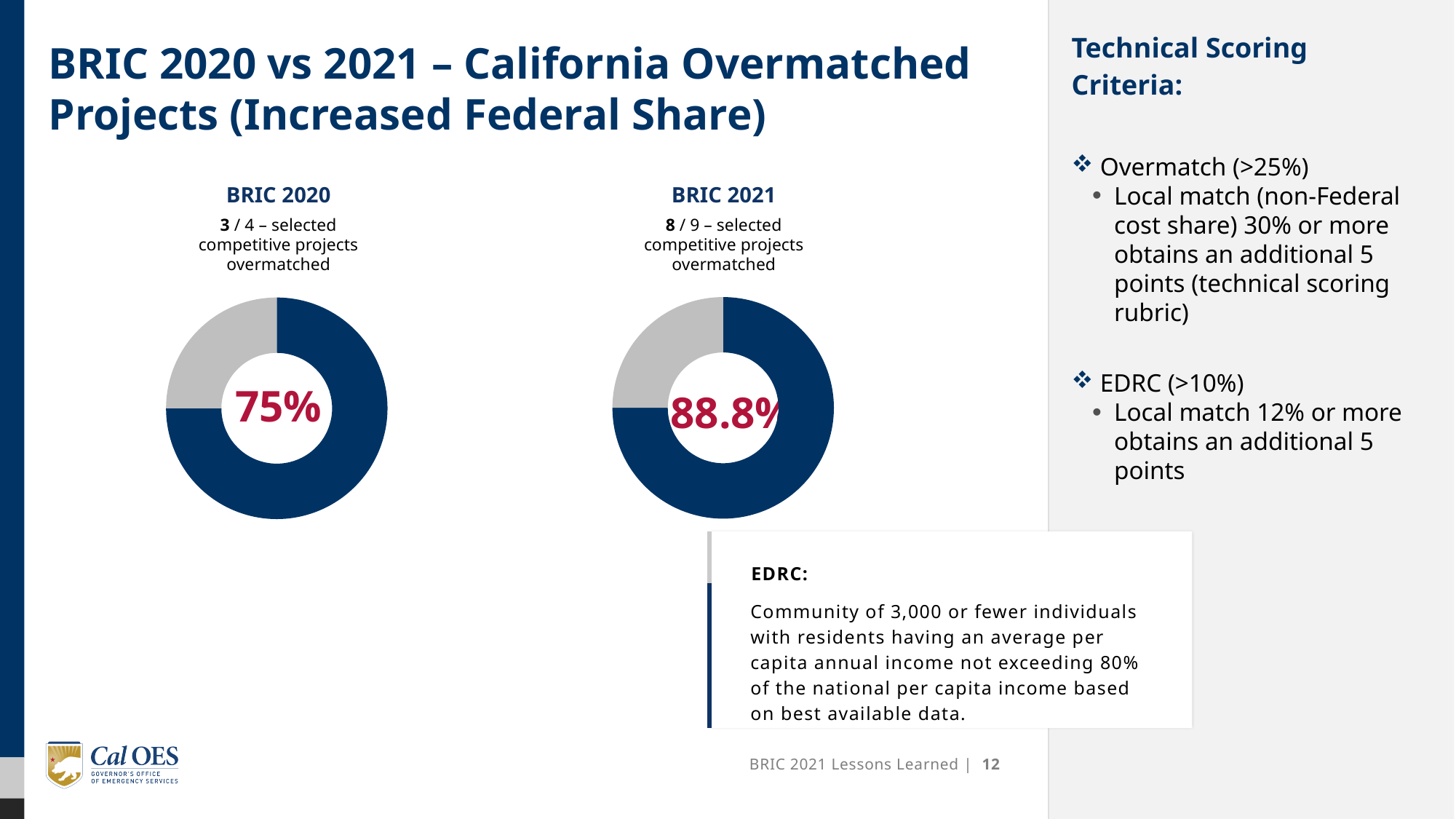
In the BRIC 2020 chart, what share of the donut is taken by the dark blue (overmatched) slice? 75% In the BRIC 2020 chart, what percentage of selected competitive projects were overmatched? 75% What is the difference in overmatched percentage between the BRIC 2021 chart and the BRIC 2020 chart? 13.8% What colour is the overmatched portion in the BRIC 2021 donut chart? Dark blue How many selected competitive projects were overmatched in BRIC 2021, according to the BRIC 2021 chart label? 8 / 9 In the BRIC 2021 chart, what percentage of selected competitive projects were overmatched? 88.8% What is the title of the chart on the left? BRIC 2020 How many slices does the BRIC 2020 donut chart have? 2 What kind of chart is used to show the BRIC 2020 overmatched share? Donut (pie) chart Which chart shows the higher overmatched percentage, BRIC 2020 or BRIC 2021? BRIC 2021 How many donut charts are shown on the slide? 2 How many selected competitive projects were overmatched in BRIC 2020, according to the BRIC 2020 chart label? 3 / 4